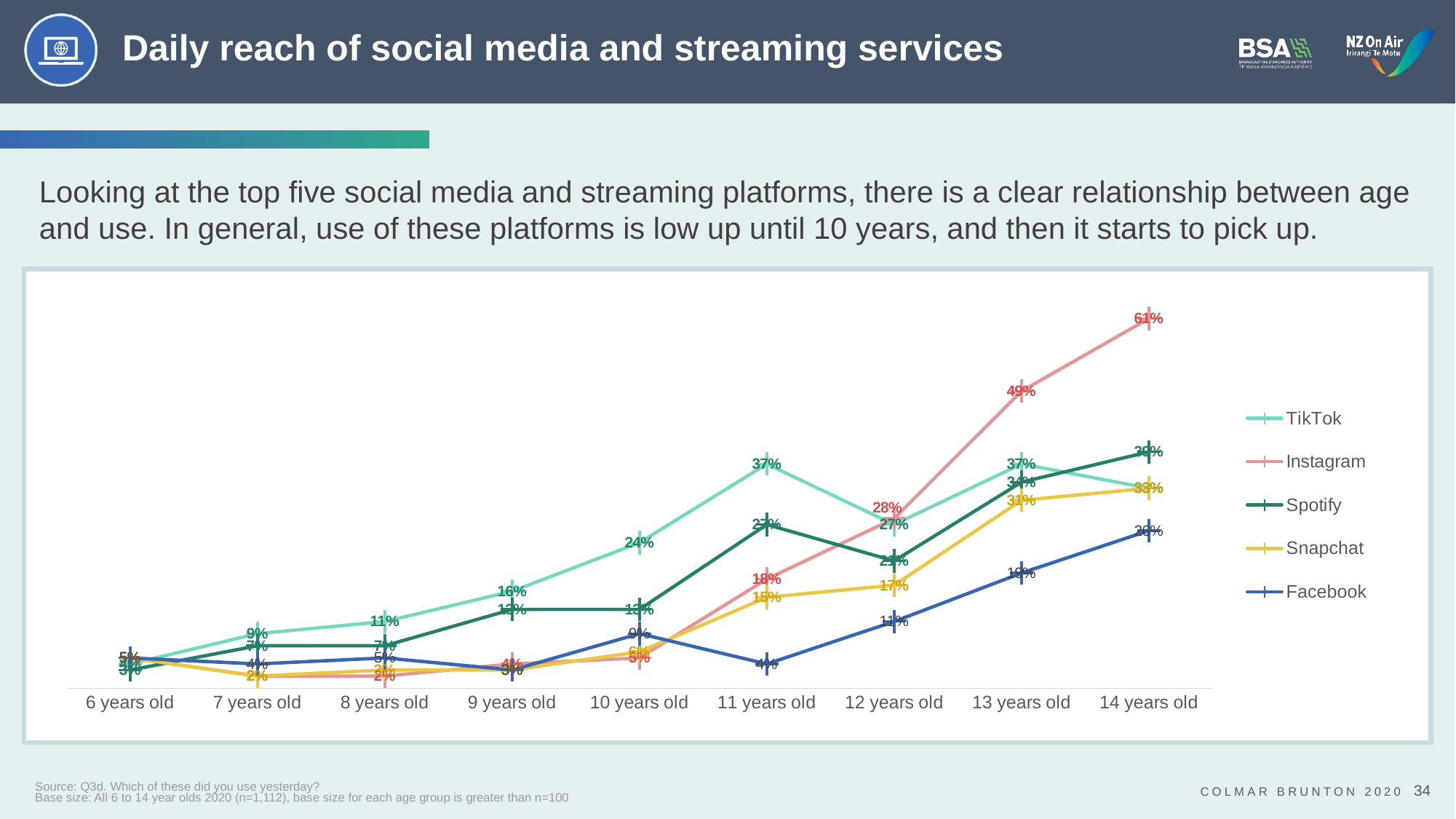
What is the daily reach of TikTok among 10 year olds? 24% What is the daily reach of Instagram among 14 year olds? 61% What is the daily reach of Instagram among 13 year olds? 49% Which platform has the highest daily reach among 14 year olds? Instagram What is the daily reach of TikTok among 11 year olds? 37% What is the daily reach of Snapchat among 13 year olds? 31% How many age groups are shown on the x axis? 9 Which platform has the lowest daily reach among 14 year olds? Facebook How many series does the legend list? 5 Among 11 year olds, which has the higher daily reach, TikTok or Instagram? TikTok By how many percentage points does Instagram's daily reach increase from 13 year olds to 14 year olds? 12 percentage points What kind of chart is shown on the slide? line chart